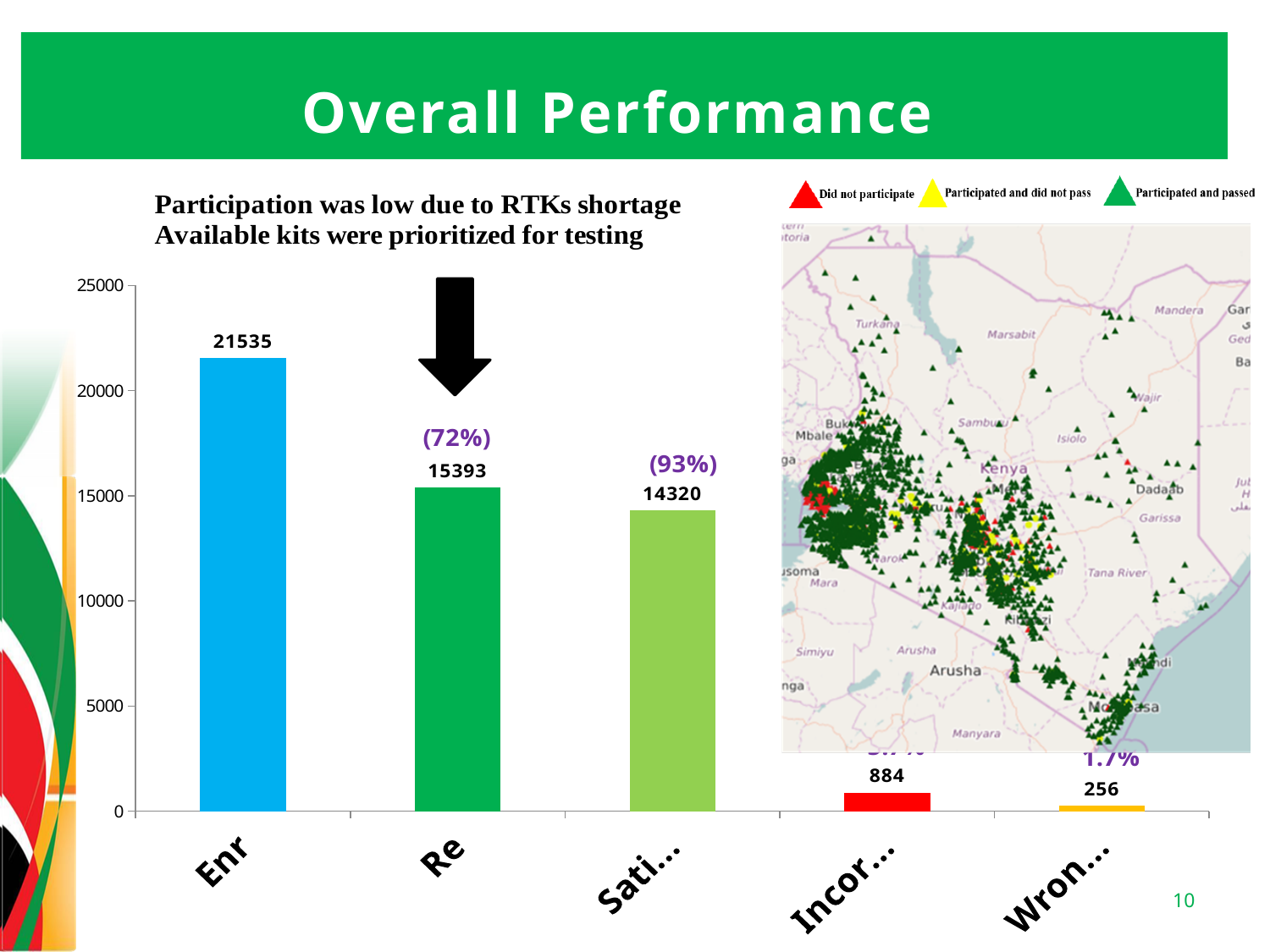
What is the value of the last bar (labelled "Wron...") in the bar chart? 256 What is the value of the fourth bar (labelled "Incor...") in the bar chart? 884 What is the value of the second bar (labelled "Re...") in the bar chart? 15393 What percentage is printed above the second bar ("Re...") in the bar chart? (72%) What kind of chart is shown on the left of the slide? bar chart What is the difference between the first bar (21535) and the second bar (15393) in the bar chart? 6142 How many bars does the bar chart have? 5 Which bar in the bar chart has the highest value? the first bar (Enr...) What is the value of the third bar (labelled "Sati...") in the bar chart? 14320 What is the value of the first bar (labelled "Enr...") in the bar chart? 21535 Which bar in the bar chart has the lowest value? the last bar (Wron...) Do the bar values rise or fall from left to right across the bar chart? fall